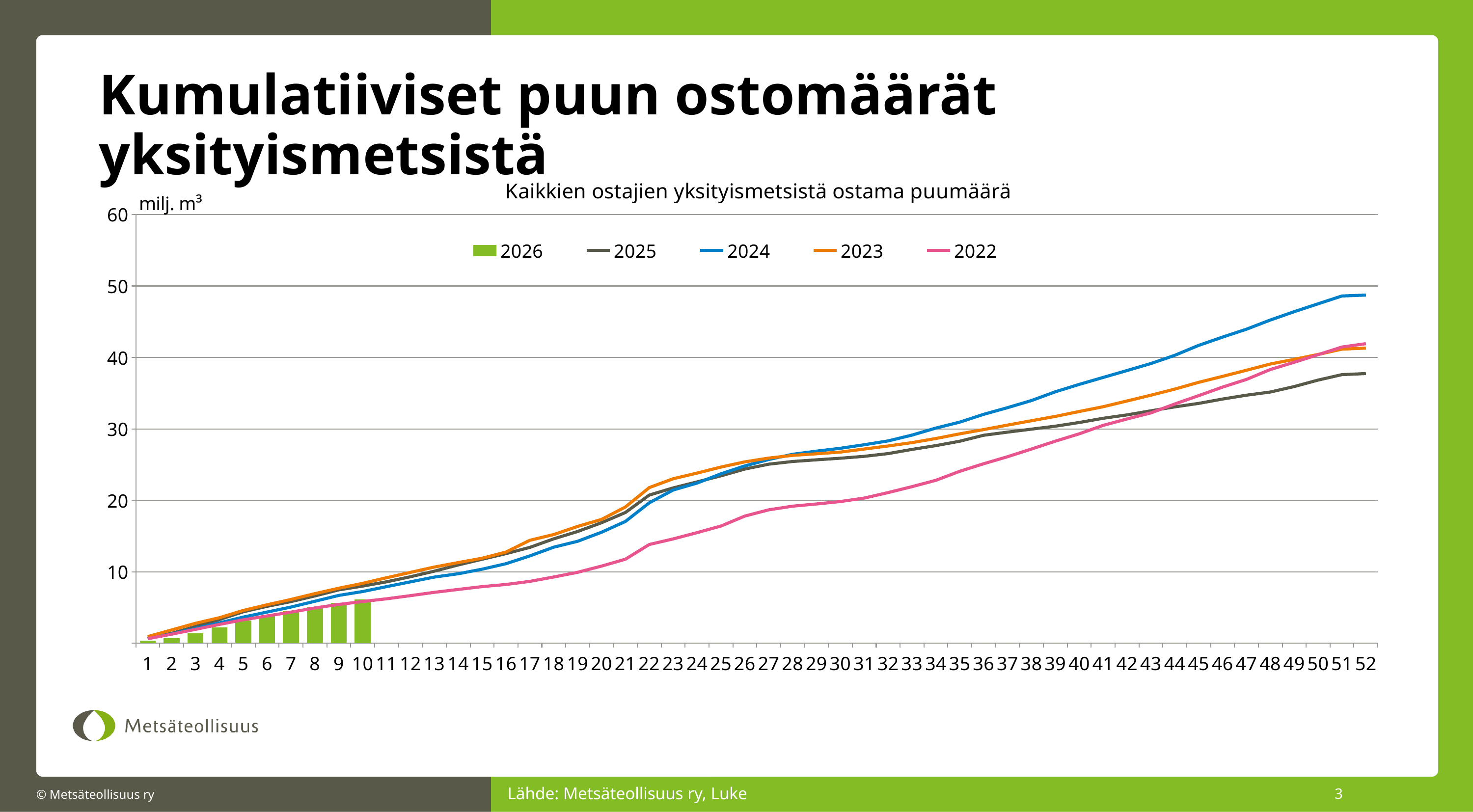
What kind of chart is this? A combined bar and line chart At week 30, which is larger, the value for 2024 or the value for 2022? 2024 Is the value for 2025 at week 52 greater or less than 40? less What is the chart's title? Kaikkien ostajien yksityismetsistä ostama puumäärä Is the value for 2024 at week 52 greater or less than 40? greater Do the values for 2024 rise or fall along the x axis? rise How many series does the legend list? 5 Which series has the highest value at week 52? 2024 Which series has the lowest value at week 52? 2025 How many points are on the x axis? 52 Which series is drawn as bars rather than a line? 2026 Is the value for 2022 at week 26 greater or less than 20? less